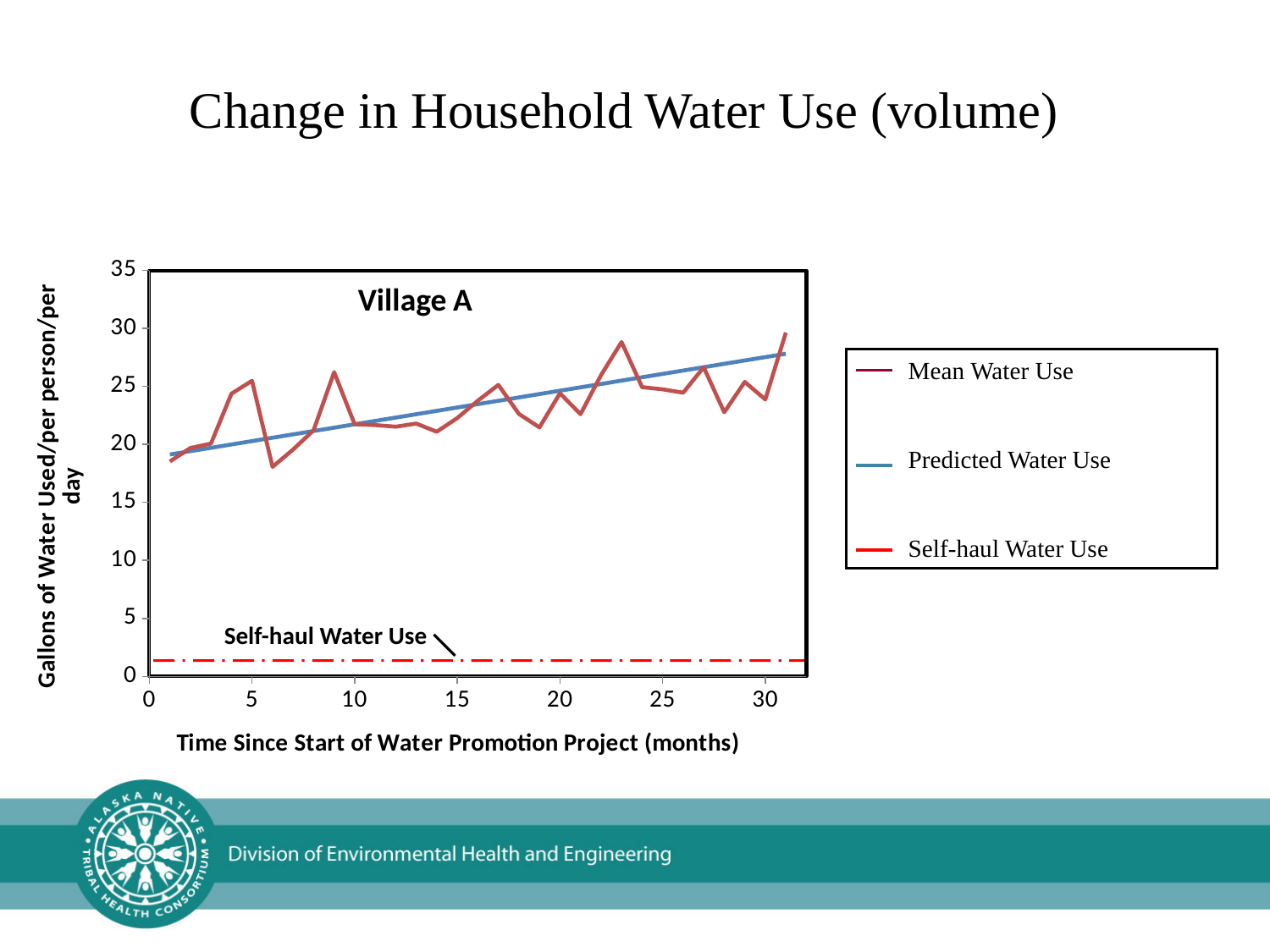
What is the label of the x axis? Time Since Start of Water Promotion Project (months) Which is larger for Mean Water Use: the value at month 6 or the value at month 23? month 23 Is the Mean Water Use value at month 6 greater or less than 20? less What kind of chart is shown on the slide? line chart Is the Mean Water Use value at month 23 greater or less than 25? greater Does the Predicted Water Use line rise or fall as time since the start of the project increases? rise What is the title printed inside the chart's plot area? Village A Which series stays flat across the whole x axis? Self-haul Water Use Is the Self-haul Water Use value greater or less than 5 gallons per person per day? less Which is larger at month 15: Mean Water Use or Self-haul Water Use? Mean Water Use How many series does the legend list? 3